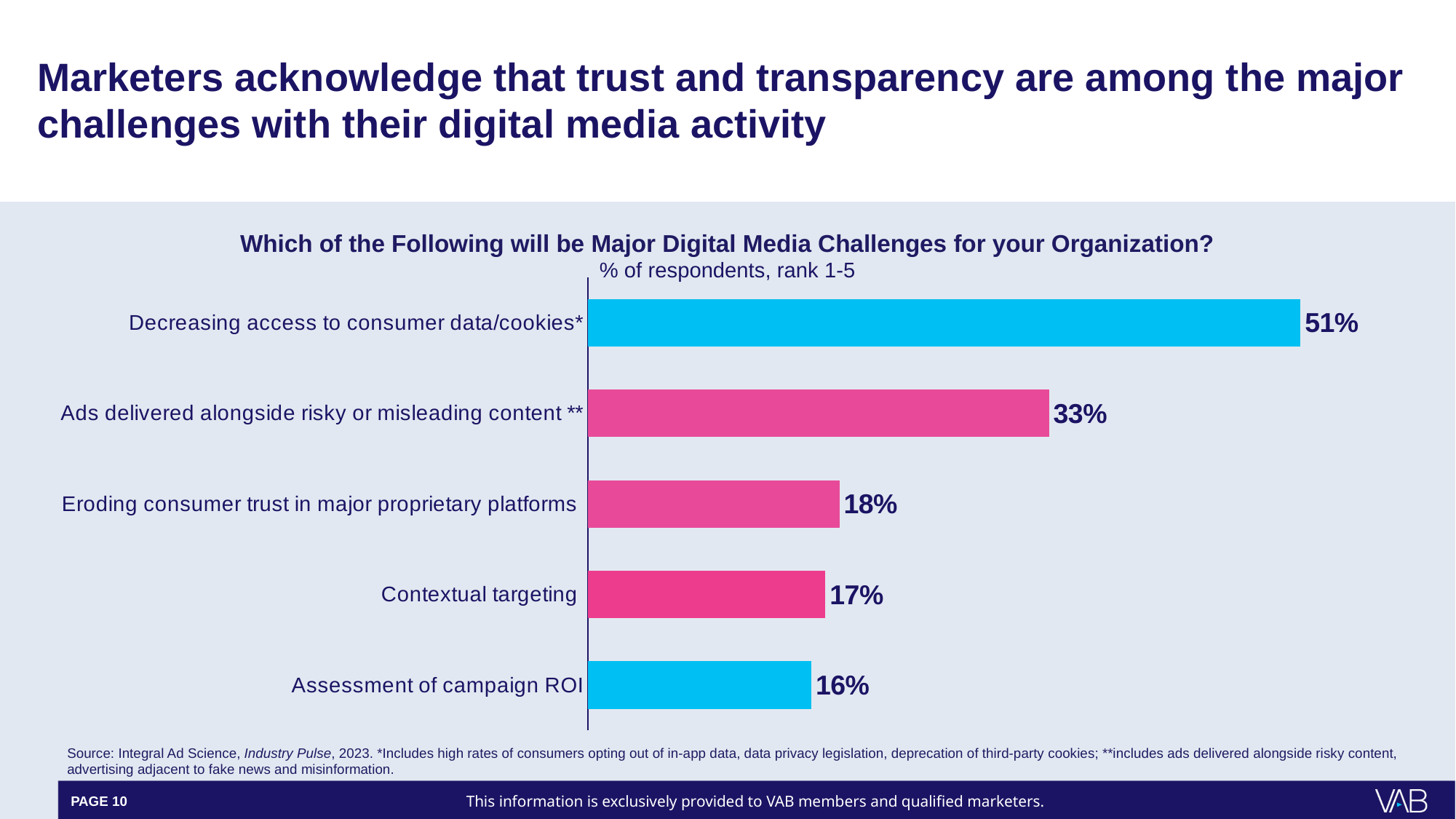
Which challenge has the highest percentage of respondents? Decreasing access to consumer data/cookies What is the difference in percentage points between 'Contextual targeting' and 'Assessment of campaign ROI'? 1 percentage point How many challenge categories are shown in the chart? 5 What is the value for 'Ads delivered alongside risky or misleading content'? 33% Which challenge has the lowest percentage of respondents? Assessment of campaign ROI Which has a higher value: 'Contextual targeting' or 'Eroding consumer trust in major proprietary platforms'? Eroding consumer trust in major proprietary platforms What is the value shown for 'Assessment of campaign ROI'? 16% What type of chart is shown on the slide? Bar chart What percentage of respondents cited decreasing access to consumer data/cookies as a major digital media challenge? 51% What percentage of respondents selected 'Eroding consumer trust in major proprietary platforms'? 18% What is the title of the chart? Which of the Following will be Major Digital Media Challenges for your Organization? What is the difference in percentage points between 'Decreasing access to consumer data/cookies' and 'Ads delivered alongside risky or misleading content'? 18 percentage points